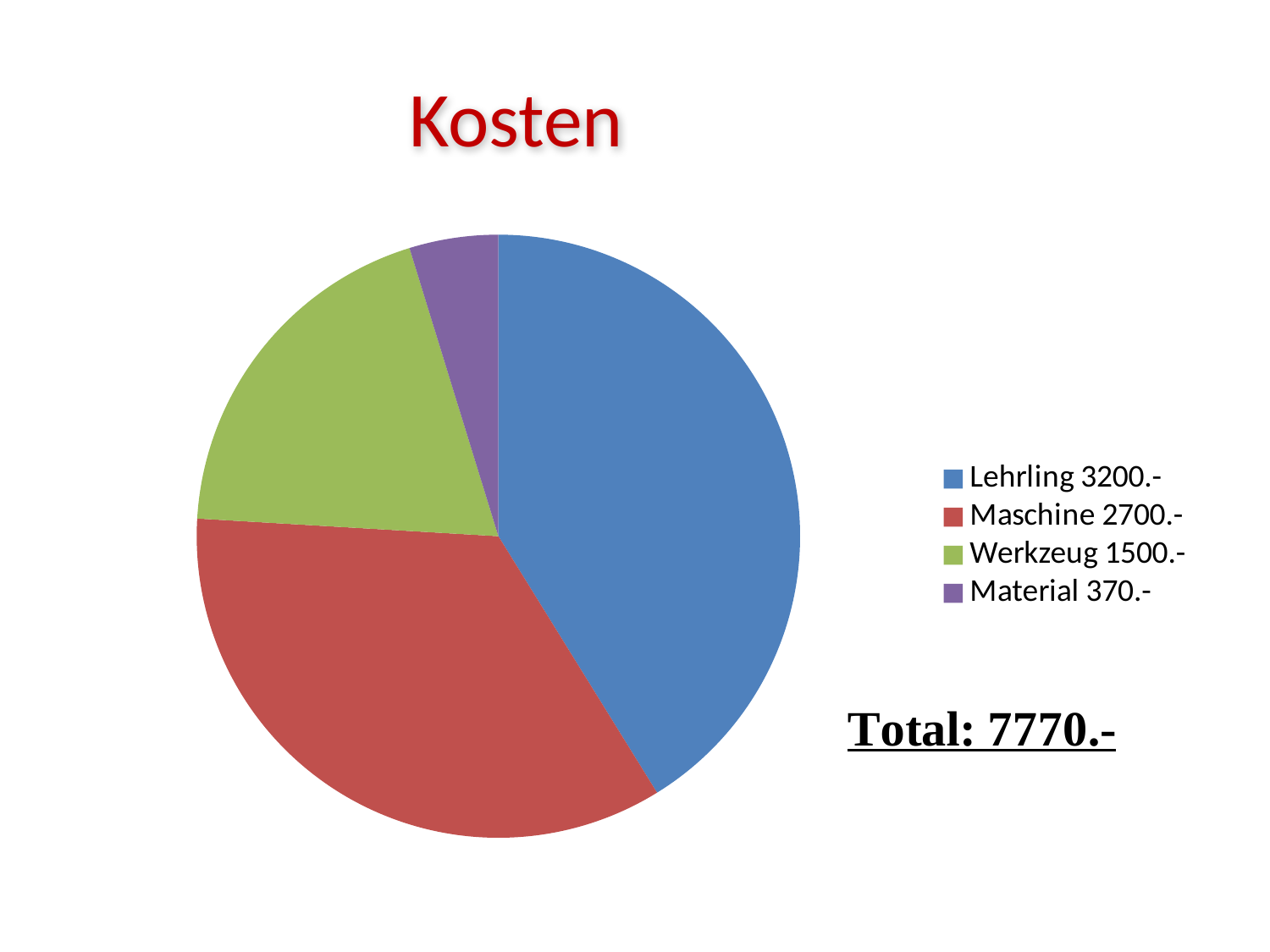
What kind of chart is shown on the slide? pie chart What is the value for Lehrling? 3200.- Which is larger, Maschine or Werkzeug? Maschine Which category has the largest slice of the pie? Lehrling How many categories does the pie chart have? 4 What is the value for Maschine? 2700.- What is the total of all categories shown on the slide? 7770.- What is the value for Werkzeug? 1500.- What is the value for Material? 370.- What is the title of the chart? Kosten Which category has the smallest slice of the pie? Material What is the difference between the values for Lehrling and Maschine? 500.-